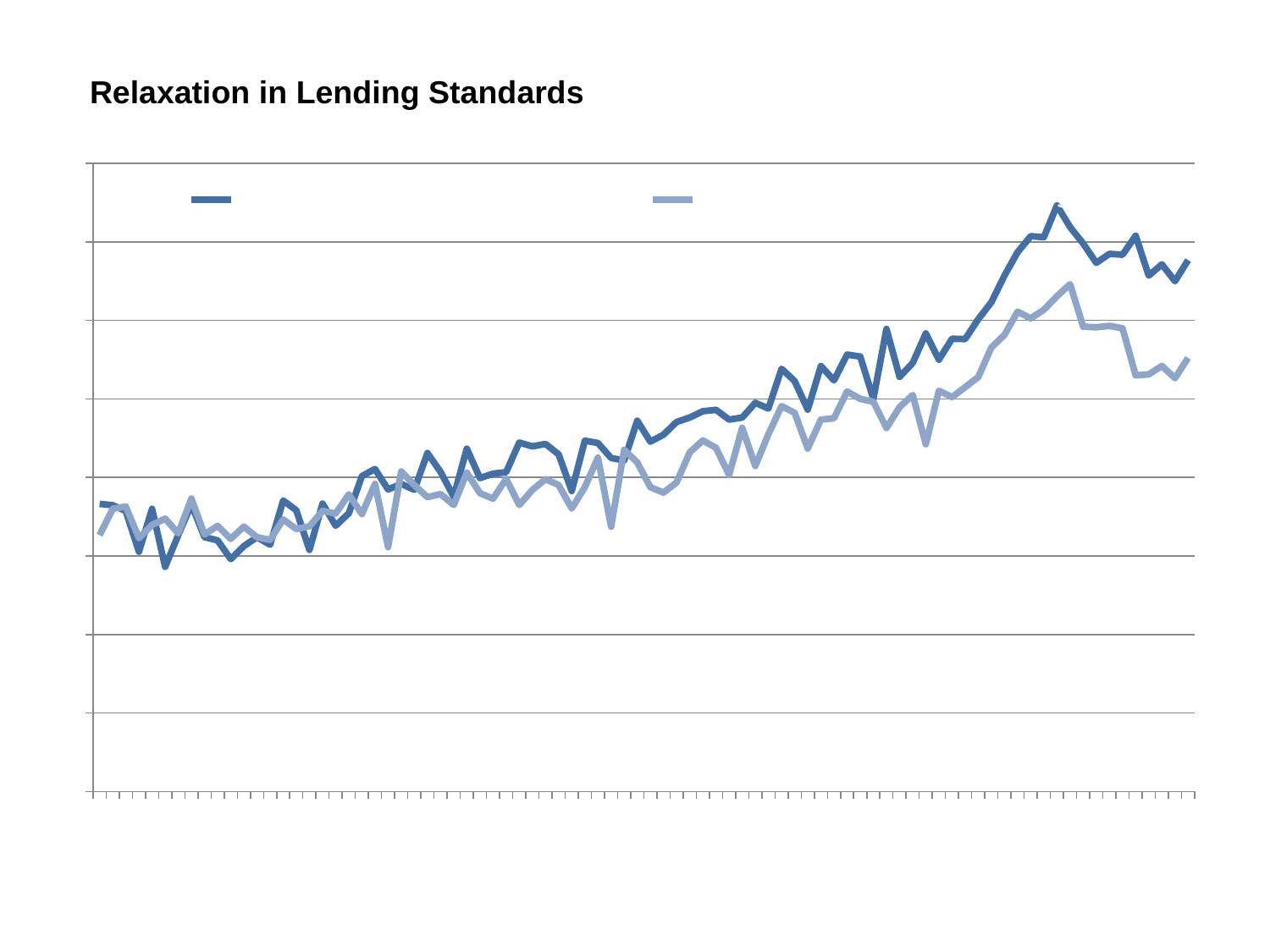
What colours are the two lines in the chart? dark blue and light blue How many series does the legend list? 2 What is the title of the chart? Relaxation in Lending Standards At the right end of the chart, which line is higher: the dark blue line or the light blue line? the dark blue line Does the light blue line end higher or lower than it starts? higher What kind of chart is shown on the slide? line chart Does the dark blue line end higher or lower than it starts? higher Do the plotted values generally rise or fall from left to right along the x axis? rise